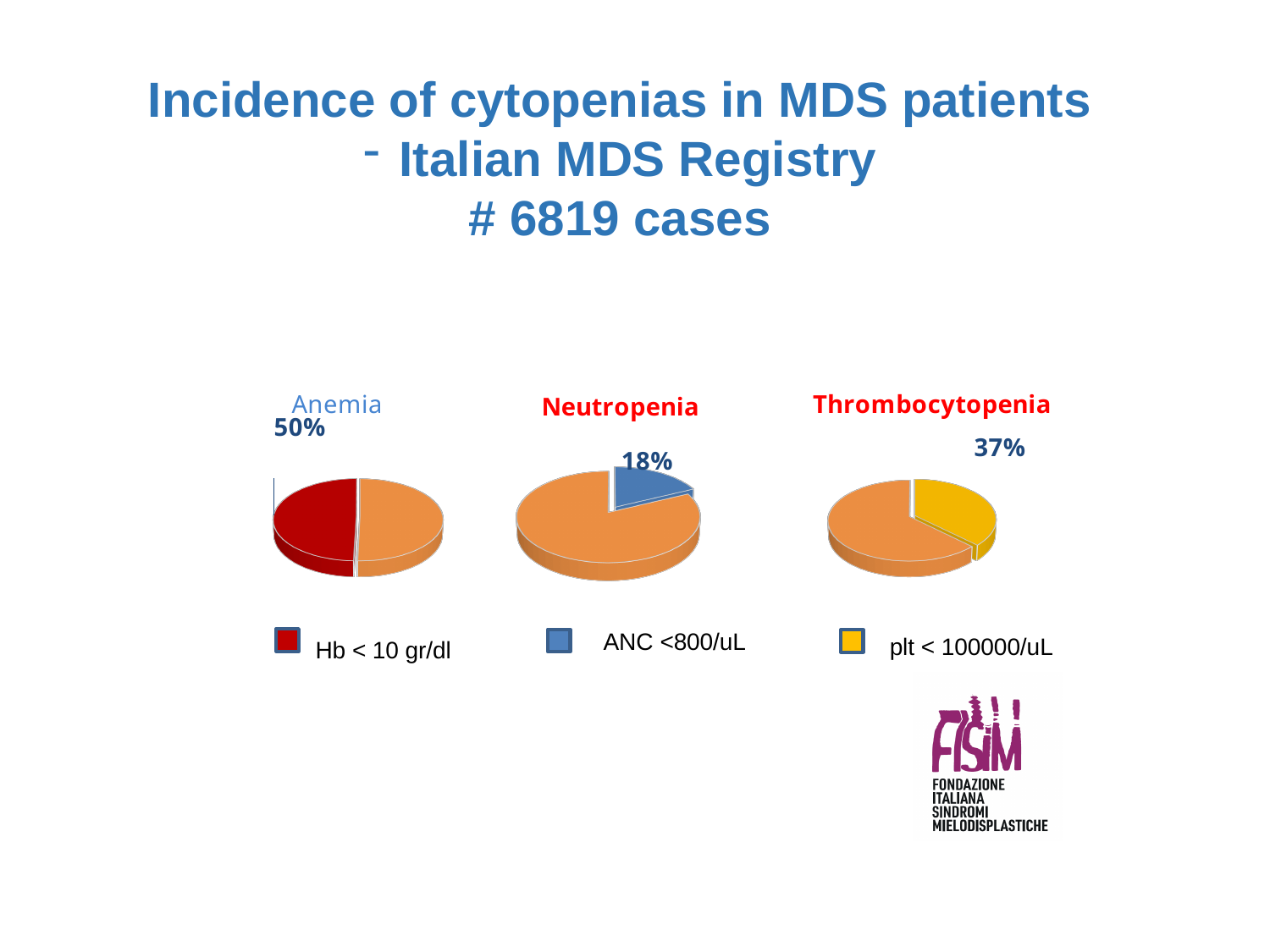
Which is larger, the Thrombocytopenia percentage or the Neutropenia percentage? Thrombocytopenia In the Thrombocytopenia pie chart, what percentage of patients have plt < 100000/uL? 37% What is the legend label under the Neutropenia pie chart? ANC <800/uL What is the difference between the Thrombocytopenia percentage and the Neutropenia percentage? 19% Across the three pie charts, which cytopenia has the lowest labelled percentage? Neutropenia What kind of chart is used to show the Anemia data? pie chart What colour is the highlighted slice in the Thrombocytopenia pie chart? yellow In the Neutropenia pie chart, what percentage of patients have ANC <800/uL? 18% What is the difference between the Anemia percentage and the Neutropenia percentage? 32% How many pie charts are shown on the slide? 3 Across the three pie charts, which cytopenia has the highest labelled percentage? Anemia In the Anemia pie chart, what percentage of patients have Hb < 10 gr/dl? 50%